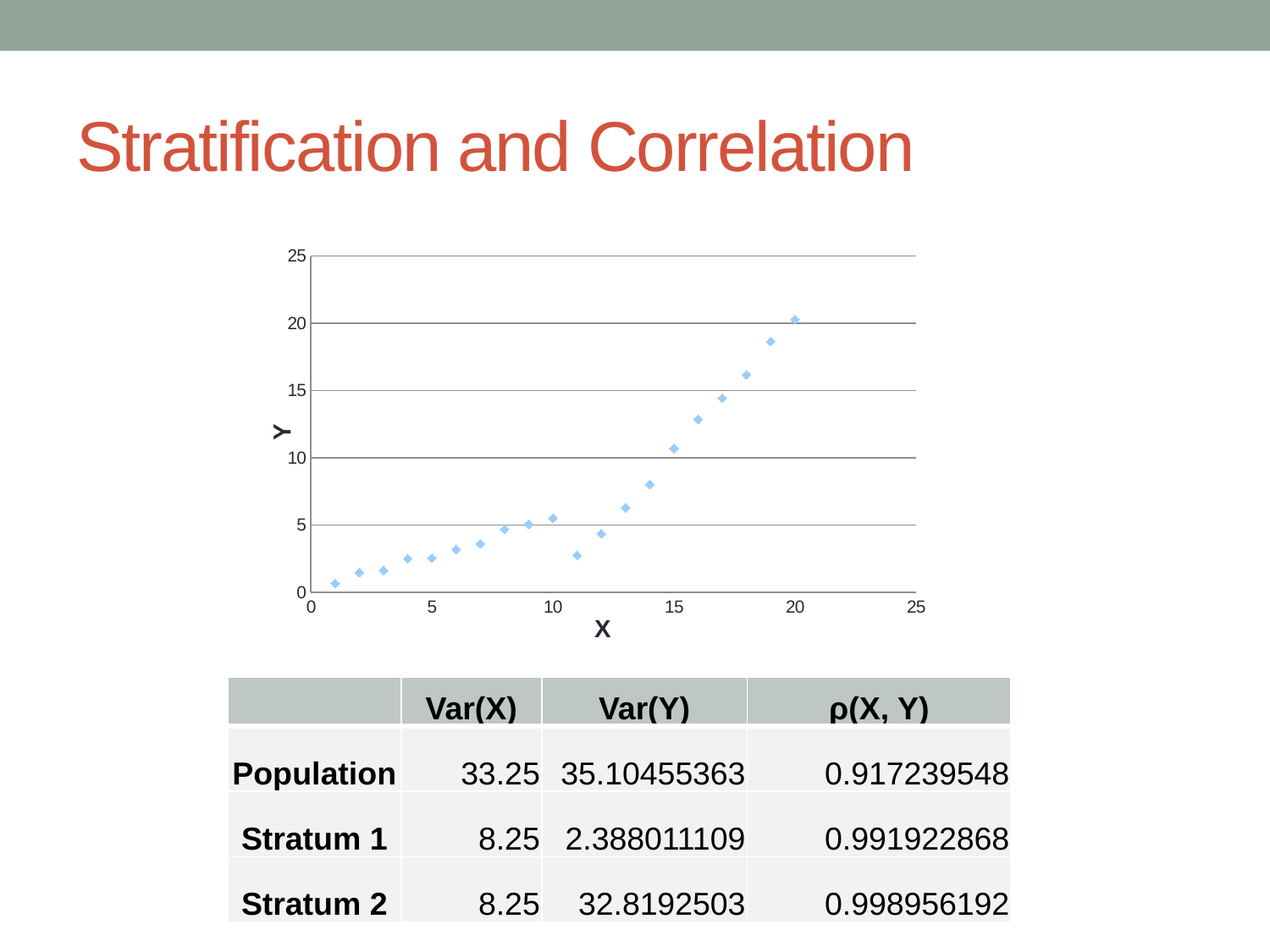
At which X value is the lowest Y value plotted? 1 Which has the larger Y value, the point at X = 10 or the point at X = 11? X = 10 Is the Y value at X = 16 greater or less than 10? greater Is the Y value at X = 11 greater or less than 5? less What kind of chart is shown on the slide? scatter chart Is the Y value at X = 1 greater or less than 5? less At which X value is the highest Y value plotted? 20 How many data points are plotted in the scatter chart? 20 What is the label of the horizontal axis of the chart? X What is the label of the vertical axis of the chart? Y Do the Y values generally rise or fall as X increases? rise